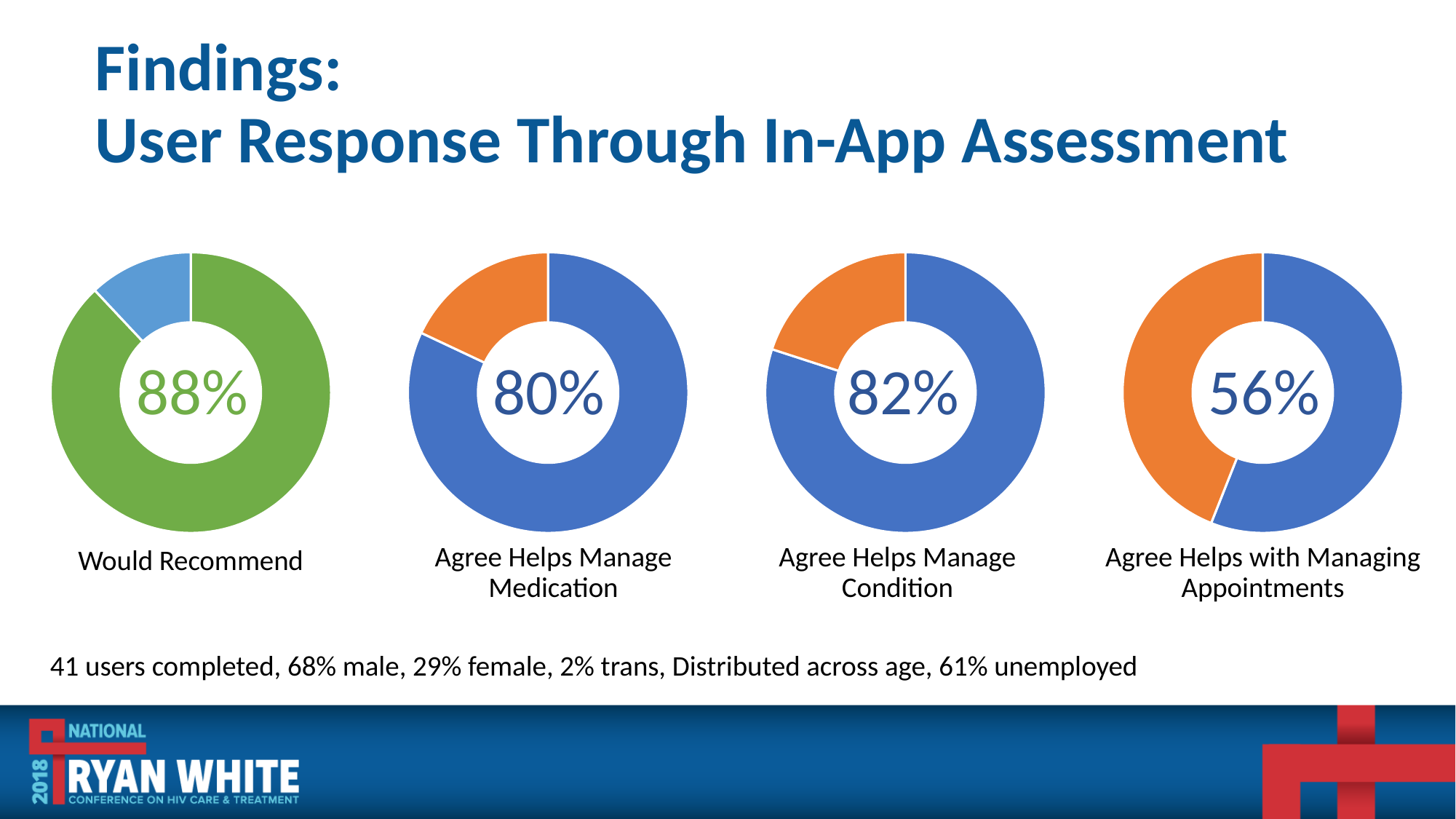
Across the four donut charts, which measure has the lowest percentage? Agree Helps with Managing Appointments What percentage is shown in the centre of the "Agree Helps Manage Medication" donut chart? 80% What is the difference in percentage points between the "Agree Helps Manage Condition" chart and the "Agree Helps Manage Medication" chart? 2 Which is larger: the percentage in the "Agree Helps Manage Condition" chart or the "Agree Helps Manage Medication" chart? Agree Helps Manage Condition What percentage is shown in the centre of the "Agree Helps Manage Condition" donut chart? 82% What percentage is shown in the centre of the "Would Recommend" donut chart? 88% Across the four donut charts, which measure has the highest percentage? Would Recommend How many donut charts are shown on the slide? 4 What kind of chart is used to show the "Would Recommend" result? Donut (pie) chart What colour is the main filled segment of the "Would Recommend" donut chart? Green What is the difference in percentage points between the "Would Recommend" chart and the "Agree Helps with Managing Appointments" chart? 32 What percentage is shown in the centre of the "Agree Helps with Managing Appointments" donut chart? 56%